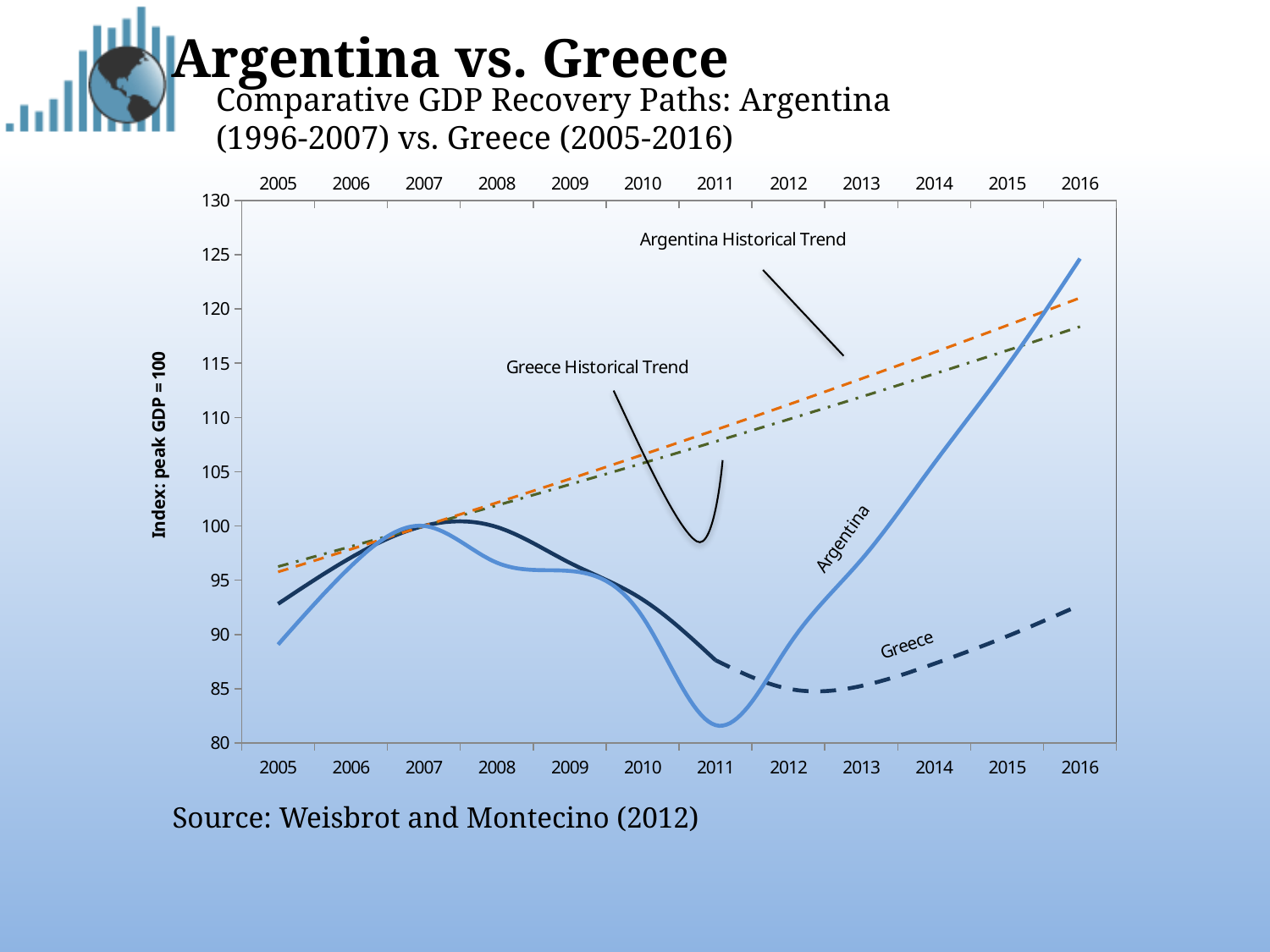
What kind of chart is shown on the slide? Line chart Is the value of the Greece line in 2016 greater or less than 90? greater What source is cited below the chart? Weisbrot and Montecino (2012) Does the Argentina line rise or fall between 2011 and 2016? Rise What is the label on the y axis of the chart? Index: peak GDP = 100 Is the value of the Argentina line in 2011 greater or less than 85? less Is the value of the Argentina line in 2016 greater or less than 120? greater In 2016, which line is higher: Argentina or Greece? Argentina In 2011, which line is higher: Argentina or Greece? Greece In which year does the Argentina line reach its lowest point? 2011 How many years are marked along the x axis of the chart? 12